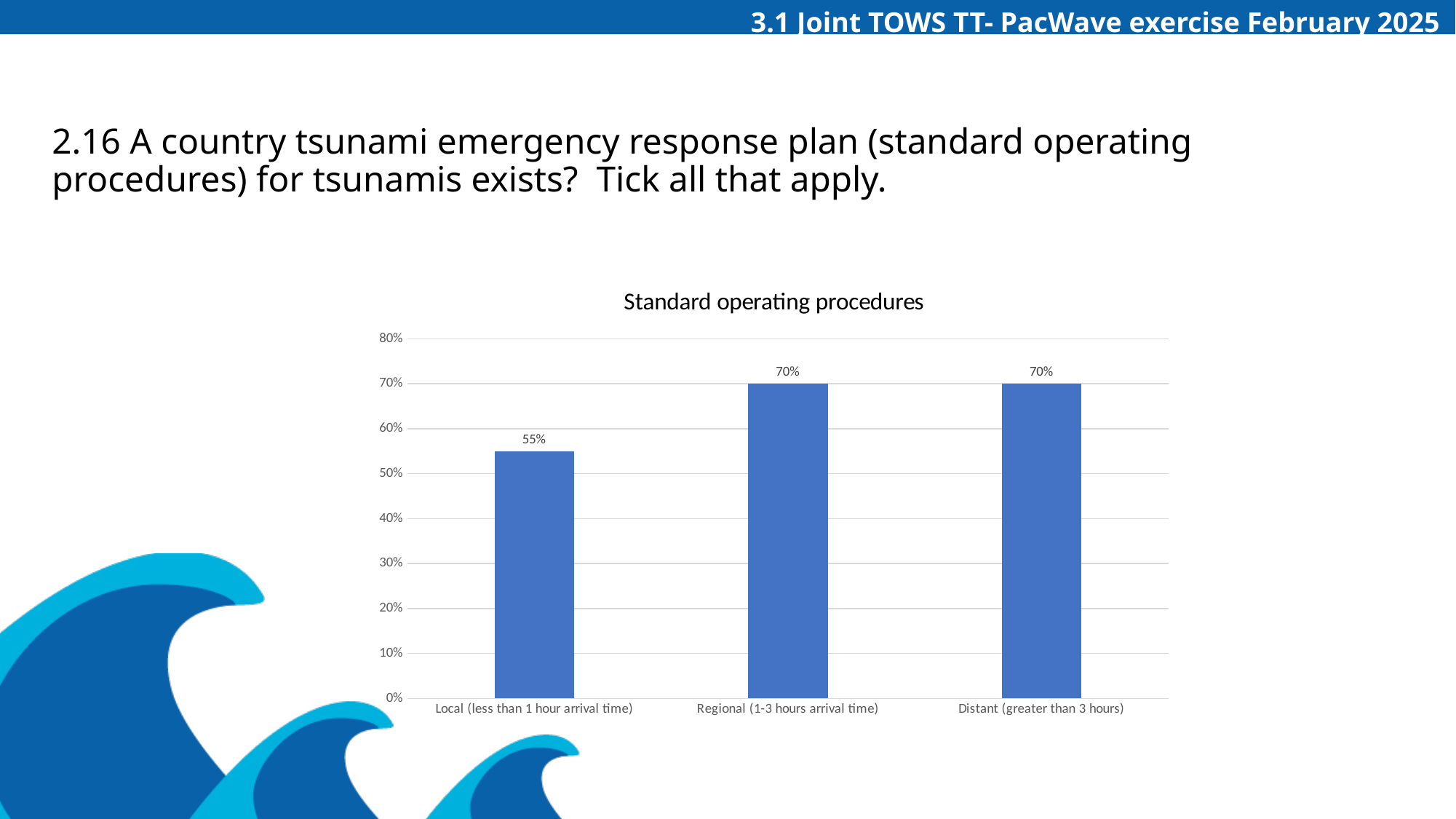
Is the value for Local (less than 1 hour arrival time) greater or less than 60%? less Which category has the lowest value? Local (less than 1 hour arrival time) What is the highest value shown on the y axis? 80% What is the value for Local (less than 1 hour arrival time)? 55% What is the value for Regional (1-3 hours arrival time)? 70% How many categories are shown on the x axis? 3 What is the value for Distant (greater than 3 hours)? 70% What kind of chart is shown on the slide? bar chart What is the difference between the values for Regional (1-3 hours arrival time) and Local (less than 1 hour arrival time)? 15% Which is larger, the value for Local (less than 1 hour arrival time) or the value for Distant (greater than 3 hours)? Distant (greater than 3 hours) What is the title of the chart? Standard operating procedures Is the value for Regional (1-3 hours arrival time) greater or less than 60%? greater